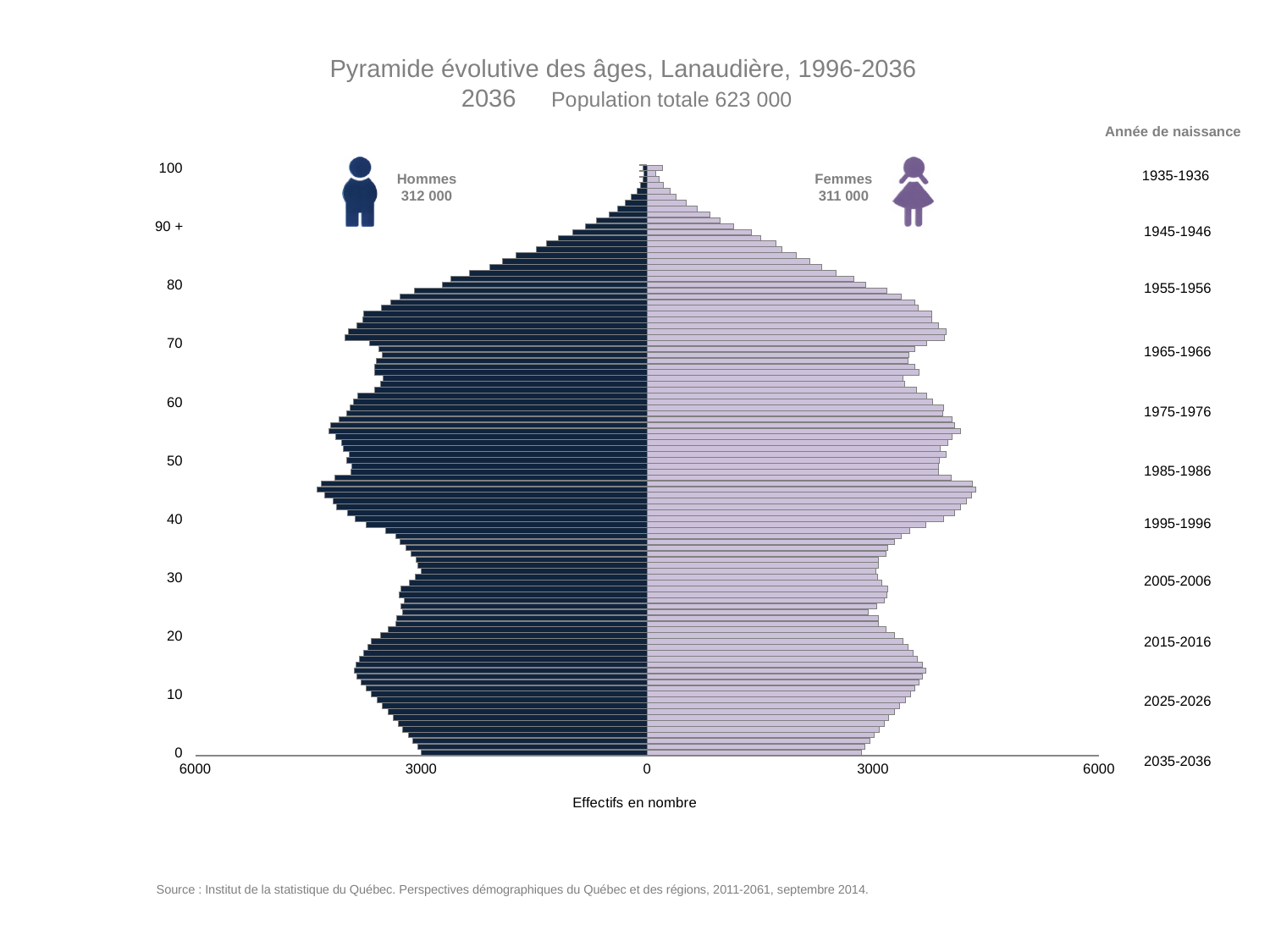
What is the label of the horizontal axis? Effectifs en nombre Which birth years correspond to age 0 on the chart? 2035-2036 What is the number of Hommes shown on the chart? 312 000 Is the value for Hommes at age 45 greater or less than 3000? greater How many groups (series) does the chart show? 2 What is the difference between the number of Hommes and the number of Femmes? 1 000 What is the total population shown for 2036? 623 000 What kind of chart is shown on the slide? Bar chart (population pyramid) What is the number of Femmes shown on the chart? 311 000 Is the value for Femmes at age 85 greater or less than 3000? less What is the title of the chart? Pyramide évolutive des âges, Lanaudière, 1996-2036 Which group is larger, Hommes or Femmes? Hommes